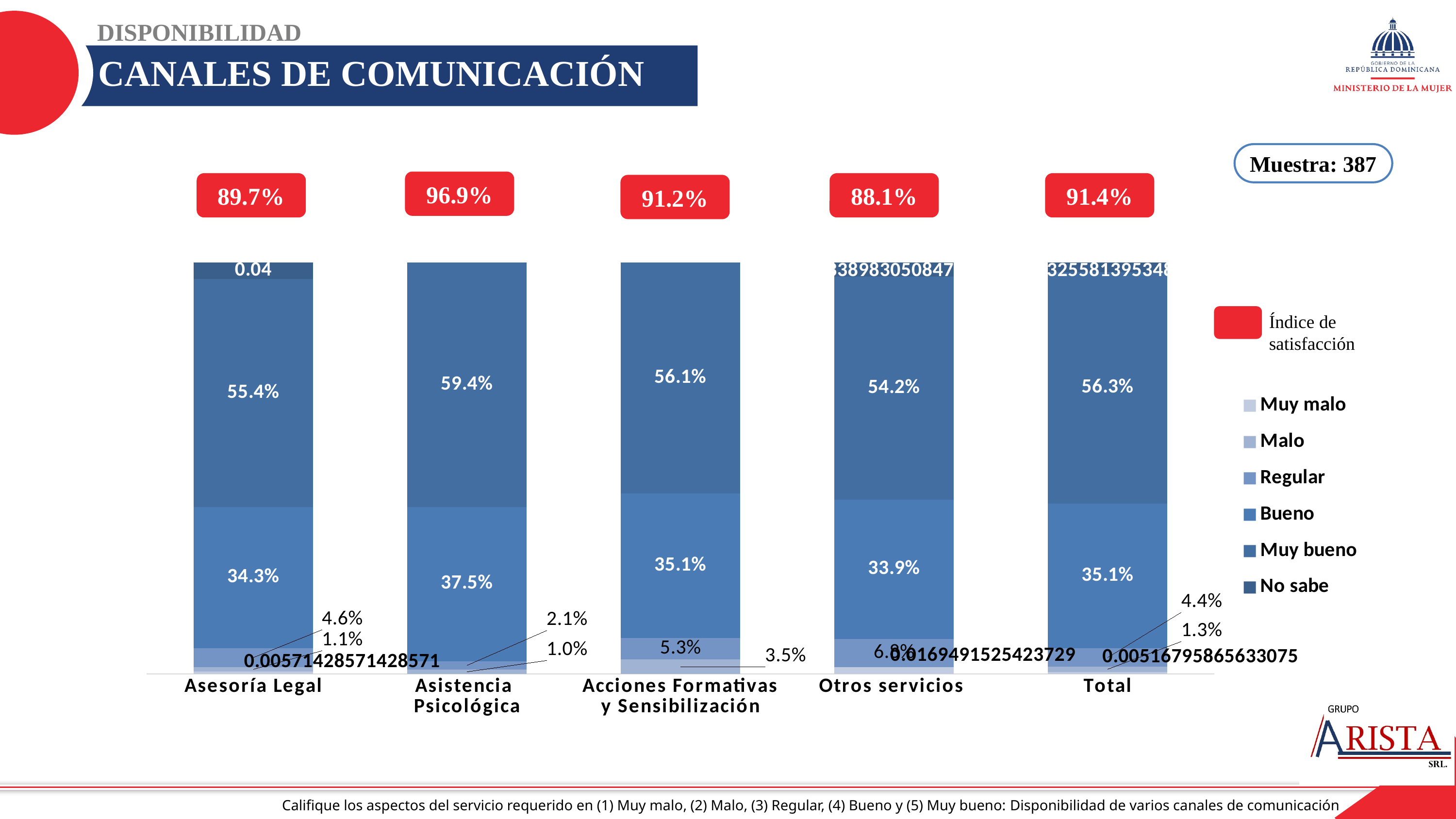
What is the Regular percentage for Acciones Formativas y Sensibilización? 5.3% What kind of chart is shown on the slide? Stacked bar chart Which category has the highest Muy bueno percentage? Asistencia Psicológica How many categories are shown on the x axis of the chart? 5 Which has a larger Muy bueno percentage: Asesoría Legal or Acciones Formativas y Sensibilización? Acciones Formativas y Sensibilización What percentage of respondents rated Total as Muy bueno? 56.3% What is the satisfaction index (Índice de satisfacción) shown for Asistencia Psicológica? 96.9% What is the Bueno percentage for Asistencia Psicológica? 37.5% How many series does the chart legend list? 6 Which category has the lowest satisfaction index? Otros servicios Which category has the highest satisfaction index? Asistencia Psicológica What is the difference between the satisfaction index of Asistencia Psicológica and that of Otros servicios? 8.8 percentage points